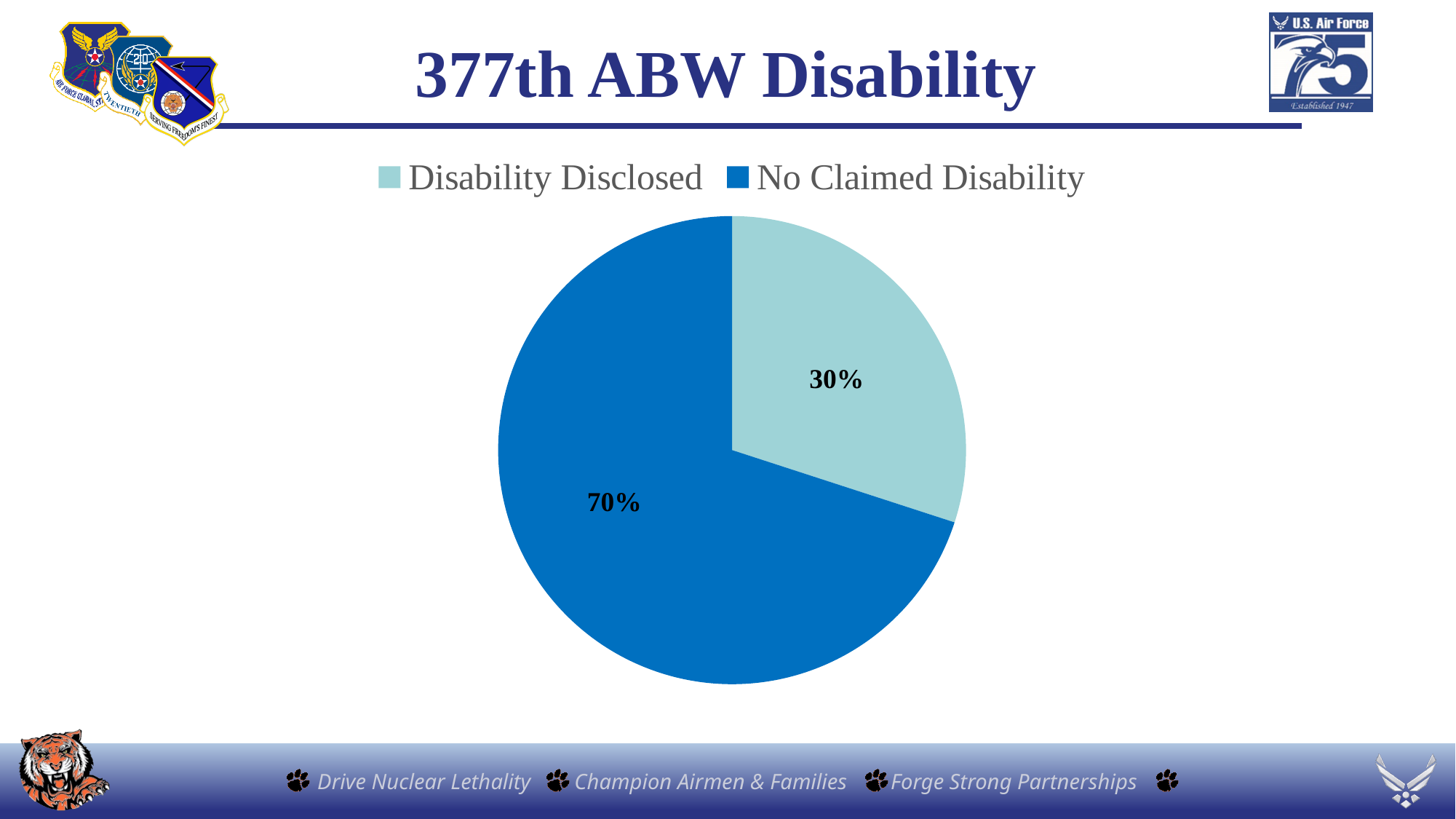
What percentage of the pie chart is labelled Disability Disclosed? 30% What kind of chart is shown on the slide? Pie chart What share of the pie does the Disability Disclosed slice represent? 30% Which is larger, the share for Disability Disclosed or the share for No Claimed Disability? No Claimed Disability Which category has the largest share of the pie chart? No Claimed Disability What percentage of the pie chart is labelled No Claimed Disability? 70% What is the title of the slide containing the chart? 377th ABW Disability How many entries does the legend list? 2 Which category has the smallest share of the pie chart? Disability Disclosed Which legend entry is shown in the lighter blue colour? Disability Disclosed How many slices does the pie chart have? 2 What is the difference in percentage points between No Claimed Disability and Disability Disclosed? 40